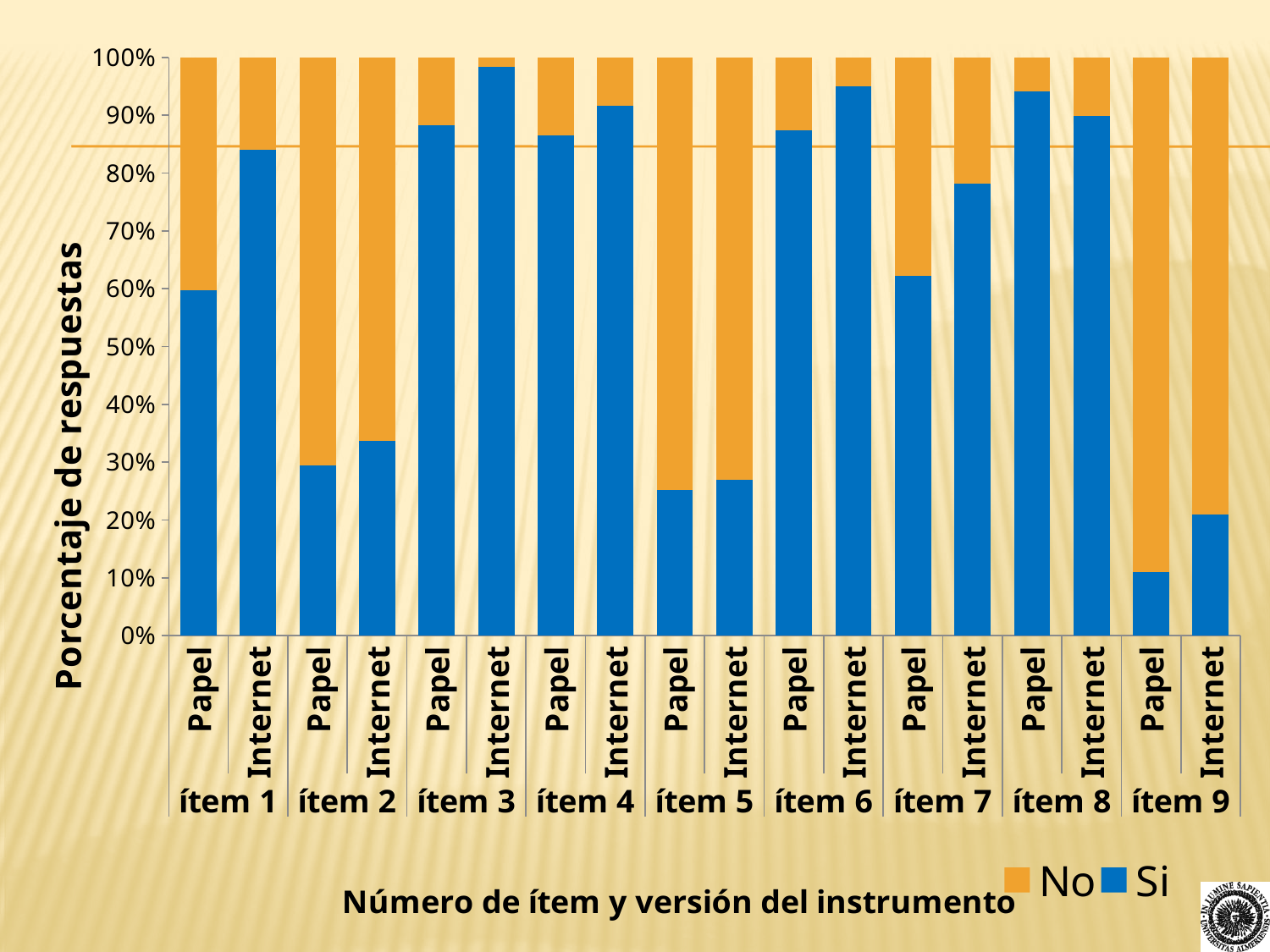
Is the 'Si' value for ítem 1 Papel greater or less than 50%? greater Which colour represents the 'Si' series in the legend? blue For ítem 1, which version has the larger 'Si' share, Papel or Internet? Internet Is the 'Si' value for ítem 5 Papel greater or less than 30%? less What kind of chart is shown on the slide? stacked bar chart Which bar has the lowest 'Si' share? ítem 9 Papel For ítem 8, which version has the larger 'Si' share, Papel or Internet? Papel How many bars are plotted in the chart? 18 Is the 'Si' value for ítem 9 Papel greater or less than 20%? less How many series does the legend list? 2 Which bar has the highest 'No' share? ítem 9 Papel